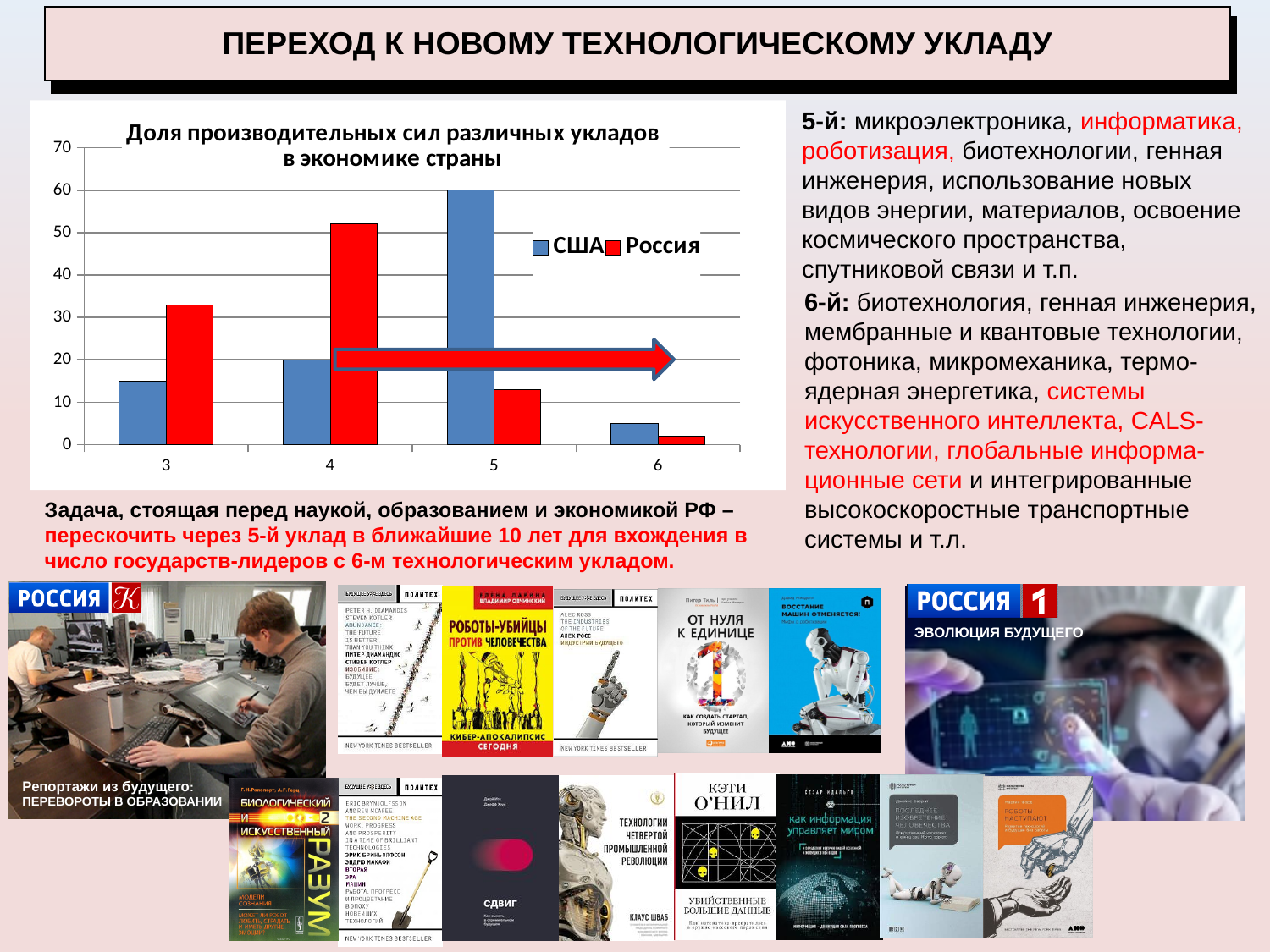
How many series does the chart legend list? 2 For which category is the value for США the highest? 5 For which category is the value for Россия the lowest? 6 Is the value for Россия at category 4 greater or less than 40? greater What is the value for США at category 5? 60 How many categories are shown on the x axis of the chart? 4 At category 3, which series has the larger value, США or Россия? Россия For which category is the value for Россия the highest? 4 At category 5, which series has the larger value, США or Россия? США Which series is shown in red in the chart? Россия What kind of chart is shown on the slide? bar chart What is the value for США at category 4? 20